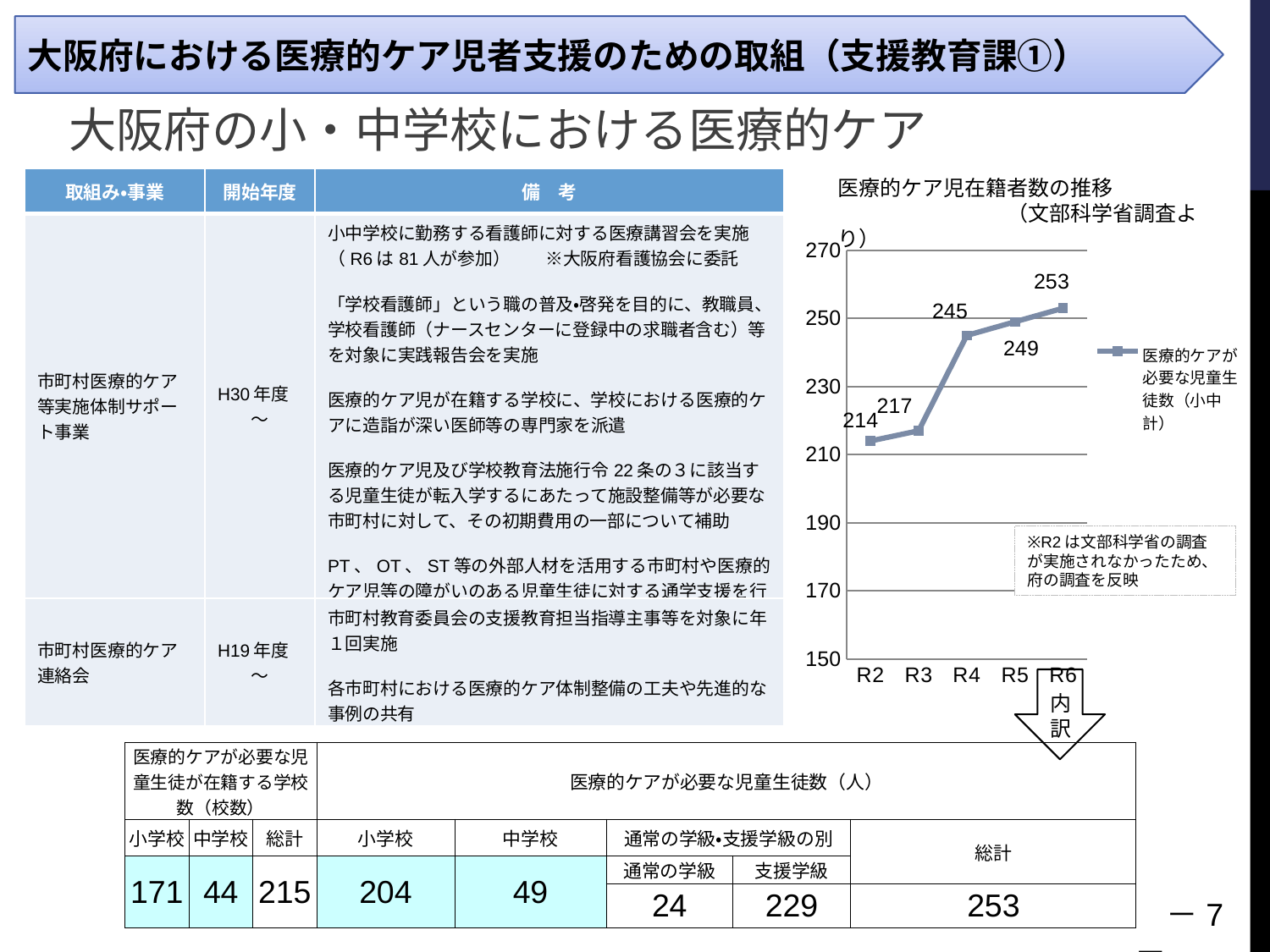
「医療的ケア児在籍者数の推移」のグラフで、最も値が小さい年度はどれですか。 R2 「医療的ケア児在籍者数の推移」のグラフはどの種類のグラフですか。 折れ線グラフ 「医療的ケア児在籍者数の推移」のグラフで、R2からR6にかけて値は増加していますか、減少していますか。 増加 「医療的ケア児在籍者数の推移」のグラフで、R4とR3の値の差はいくつですか。 28 「医療的ケア児在籍者数の推移」のグラフで、R5とR3ではどちらの値が大きいですか。 R5 「医療的ケア児在籍者数の推移」のグラフで、R6とR2の値の差はいくつですか。 39 「医療的ケア児在籍者数の推移」のグラフで、R3の値は230より大きいですか、小さいですか。 小さい 「医療的ケア児在籍者数の推移」のグラフで、R6の値はいくつですか。 253 「医療的ケア児在籍者数の推移」のグラフで、最も値が大きい年度はどれですか。 R6 「医療的ケア児在籍者数の推移」のグラフで、R2の値はいくつですか。 214 「医療的ケア児在籍者数の推移」のグラフには、横軸にいくつの年度が示されていますか。 5 「医療的ケア児在籍者数の推移」のグラフで、R4の値はいくつですか。 245